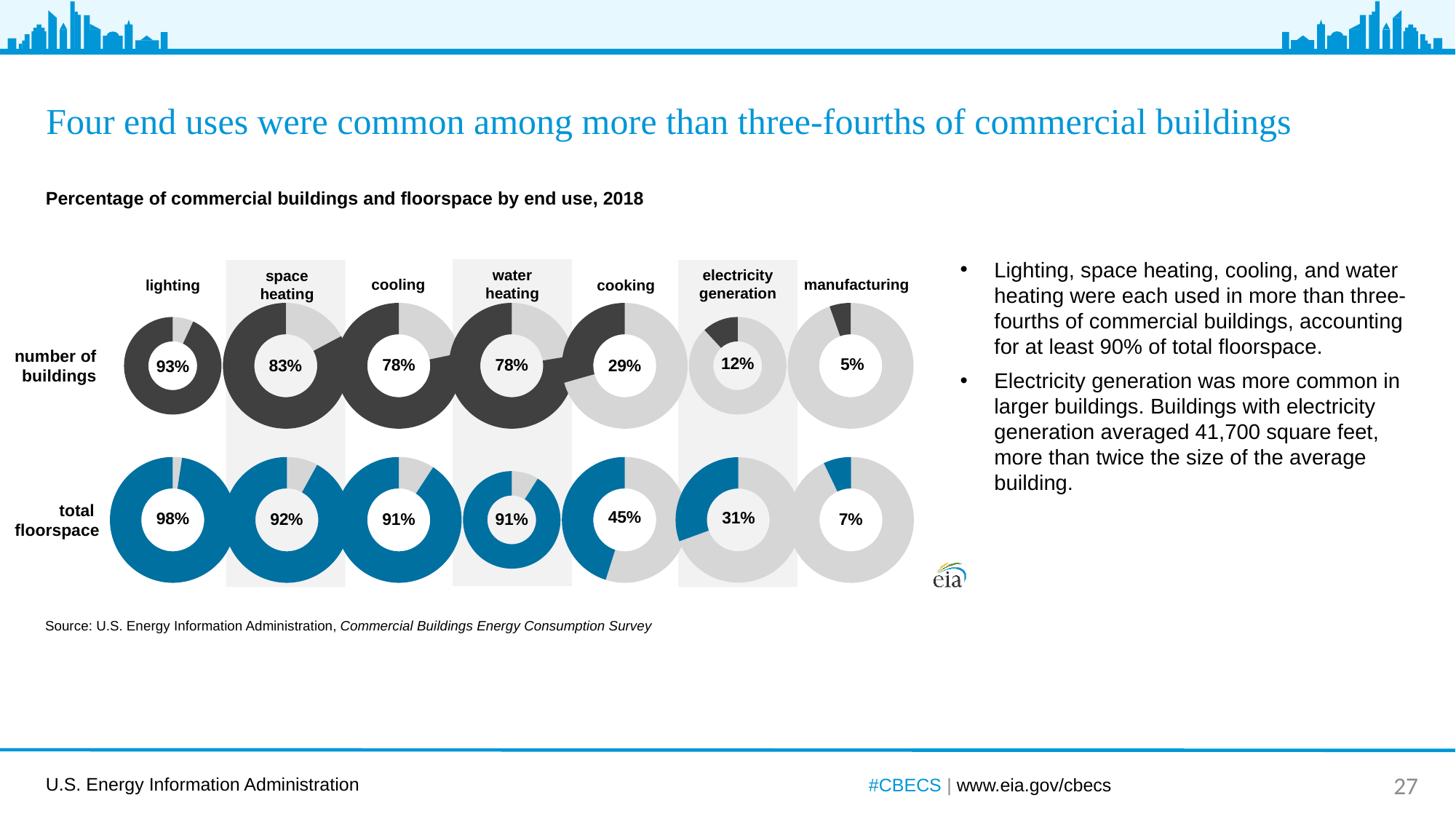
In the 'total floorspace' row, what percentage is shown for cooking? 45% Which end use has the highest percentage in the 'total floorspace' row? lighting What is the difference between the 'total floorspace' and 'number of buildings' percentages for electricity generation? 19 percentage points What percentage of buildings have electricity generation in the 'number of buildings' row? 12% Which is larger: the 'number of buildings' percentage for cooking or for electricity generation? cooking What kind of chart is used to show the percentages on this slide? donut (pie) chart What is the difference between the 'total floorspace' percentages for space heating and cooking? 47 percentage points Do the percentages in the 'number of buildings' row rise or fall moving from lighting to manufacturing? fall Which end use has the lowest percentage in the 'number of buildings' row? manufacturing How many end uses are shown in the chart? 7 What percentage of commercial buildings use lighting, according to the 'number of buildings' row? 93% What is the title of the chart? Percentage of commercial buildings and floorspace by end use, 2018